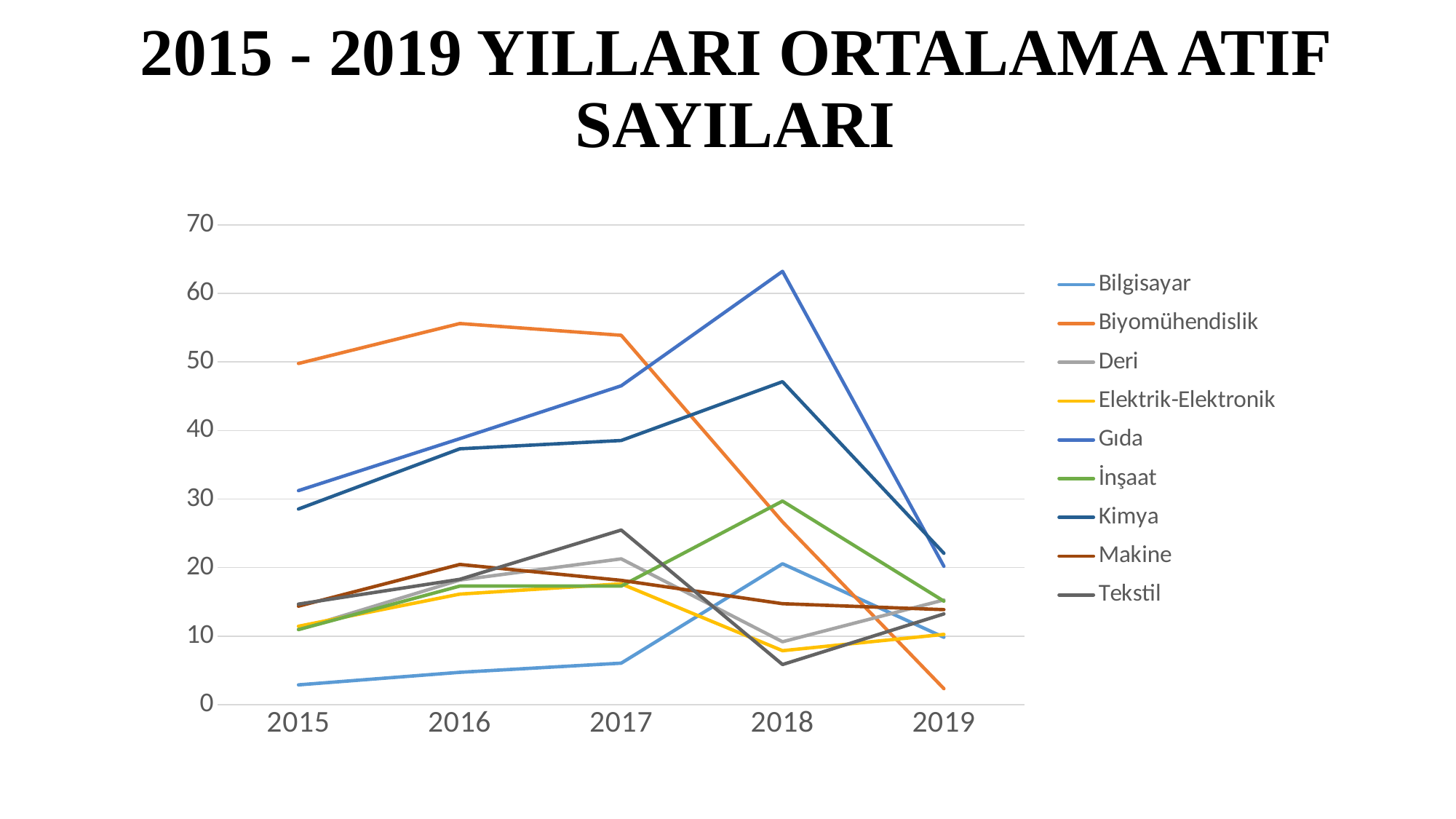
What is the title of the slide? 2015 - 2019 YILLARI ORTALAMA ATIF SAYILARI Which series has the highest value in 2018? Gıda Which series has the lowest value in 2015? Bilgisayar Is the value for Gıda in 2018 greater or less than 60? greater How many years are shown on the x axis? 5 Which series has the highest value in 2015? Biyomühendislik Is the value for Biyomühendislik in 2019 greater or less than 10? less Does the Biyomühendislik line rise or fall from 2017 to 2019? falls In 2017, which is larger: Gıda or Kimya? Gıda What kind of chart is shown on the slide? line chart How many series does the legend list? 9 Does the Gıda line rise or fall from 2015 to 2018? rises